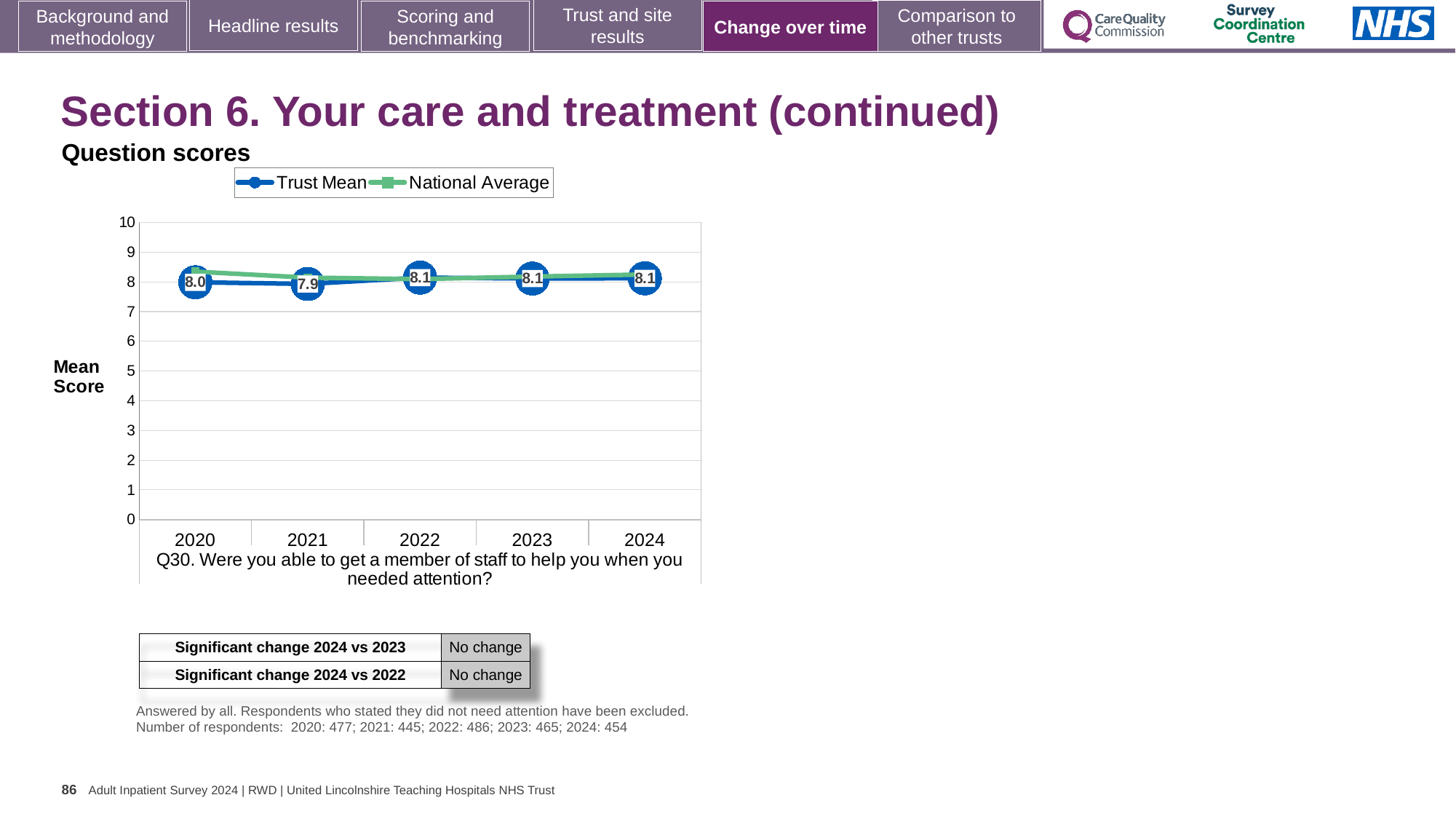
Between 2021 and 2022, does the Trust Mean score rise or fall? rise What is the difference between the Trust Mean scores for 2022 and 2021? 0.2 What is the Trust Mean score for 2020? 8.0 In which year is the Trust Mean score lowest? 2021 How many years are plotted on the x axis? 5 What is the Trust Mean score for 2021? 7.9 How many series does the legend list? 2 Is the National Average value for 2020 greater or less than 8? greater What is the Trust Mean score for 2024? 8.1 What is the label of the y axis? Mean Score Which is larger, the Trust Mean score for 2020 or for 2021? 2020 What kind of chart is shown? Line chart